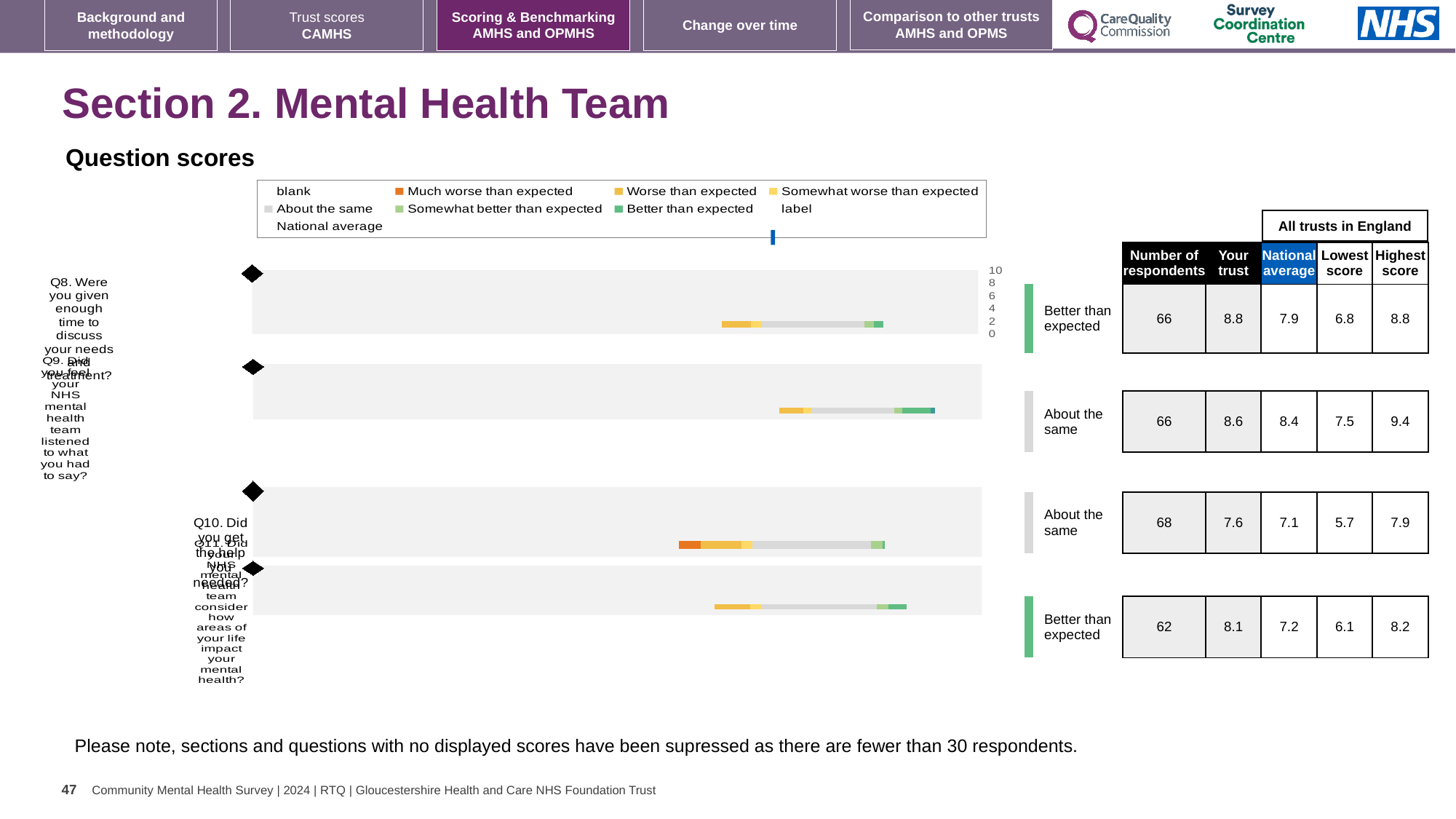
What is the 'Your trust' score for Q8 (Were you given enough time to discuss your needs and treatment?)? 8.8 For Q10, what is the difference between the 'Your trust' score and the national average? 0.5 What is the lowest score among all trusts in England for Q11? 6.1 How many respondents are listed for Q10 (Did you get the help you needed?)? 68 How many questions (categories) are plotted in the question scores chart? 4 What colour does the legend use for 'Much worse than expected'? orange What benchmark category is shown for Q8? Better than expected For Q9, which is larger: the 'Your trust' score or the national average? Your trust What type of chart is used to show the question scores on this slide? bar chart Which question has the lowest 'Your trust' score? Q10 Which question has the highest 'Your trust' score? Q8 What is the national average score for Q9 (Did you feel your NHS mental health team listened to what you had to say?)? 8.4